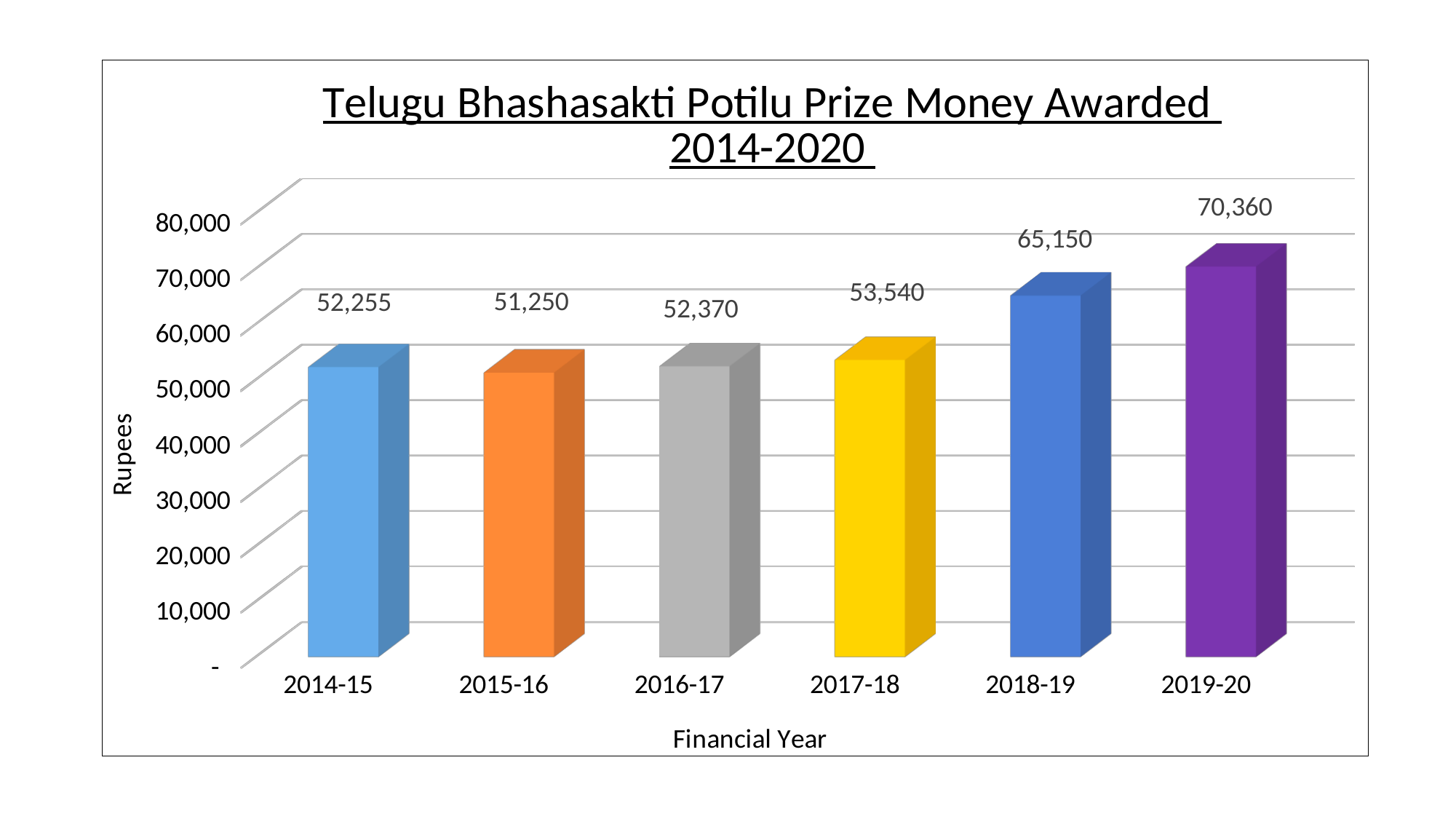
What is the label of the vertical axis? Rupees Which financial year had the highest prize money awarded? 2019-20 Which financial year had the lowest prize money awarded? 2015-16 Which year had more prize money awarded, 2018-19 or 2017-18? 2018-19 What was the prize money awarded in 2014-15? 52,255 What is the difference in prize money between 2017-18 and 2016-17? 1,170 What is the difference in prize money between 2019-20 and 2018-19? 5,210 Is the prize money for 2018-19 greater or less than 60,000? greater What kind of chart is shown on the slide? Bar chart What was the prize money awarded in 2019-20? 70,360 What was the prize money awarded in 2017-18? 53,540 How many financial years are shown on the chart? 6